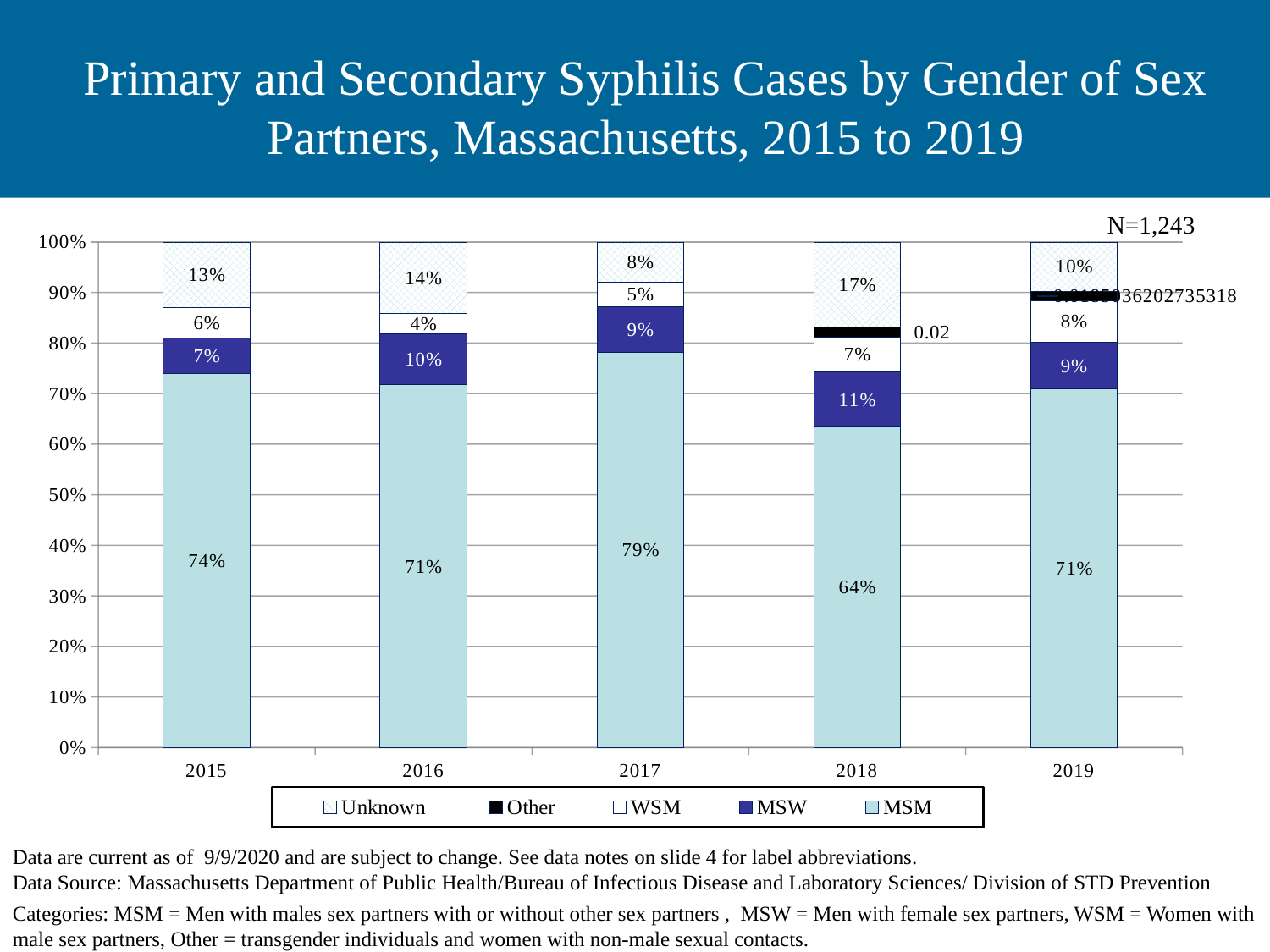
What is the WSM share of cases in 2019? 8% How many series does the legend list? 5 What is the Unknown share of cases in 2016? 14% What is the MSW share of cases in 2018? 11% Which is larger, the Unknown share in 2018 or the Unknown share in 2019? 2018 What is the difference between the MSM share in 2015 and the MSM share in 2018? 10% What type of chart is shown on the slide? stacked bar chart In which year is the MSM share of cases highest? 2017 How many years are shown on the x axis? 5 What is the total N shown on the chart? N=1,243 In which year is the MSM share of cases lowest? 2018 What is the MSM share of primary and secondary syphilis cases in 2017? 79%